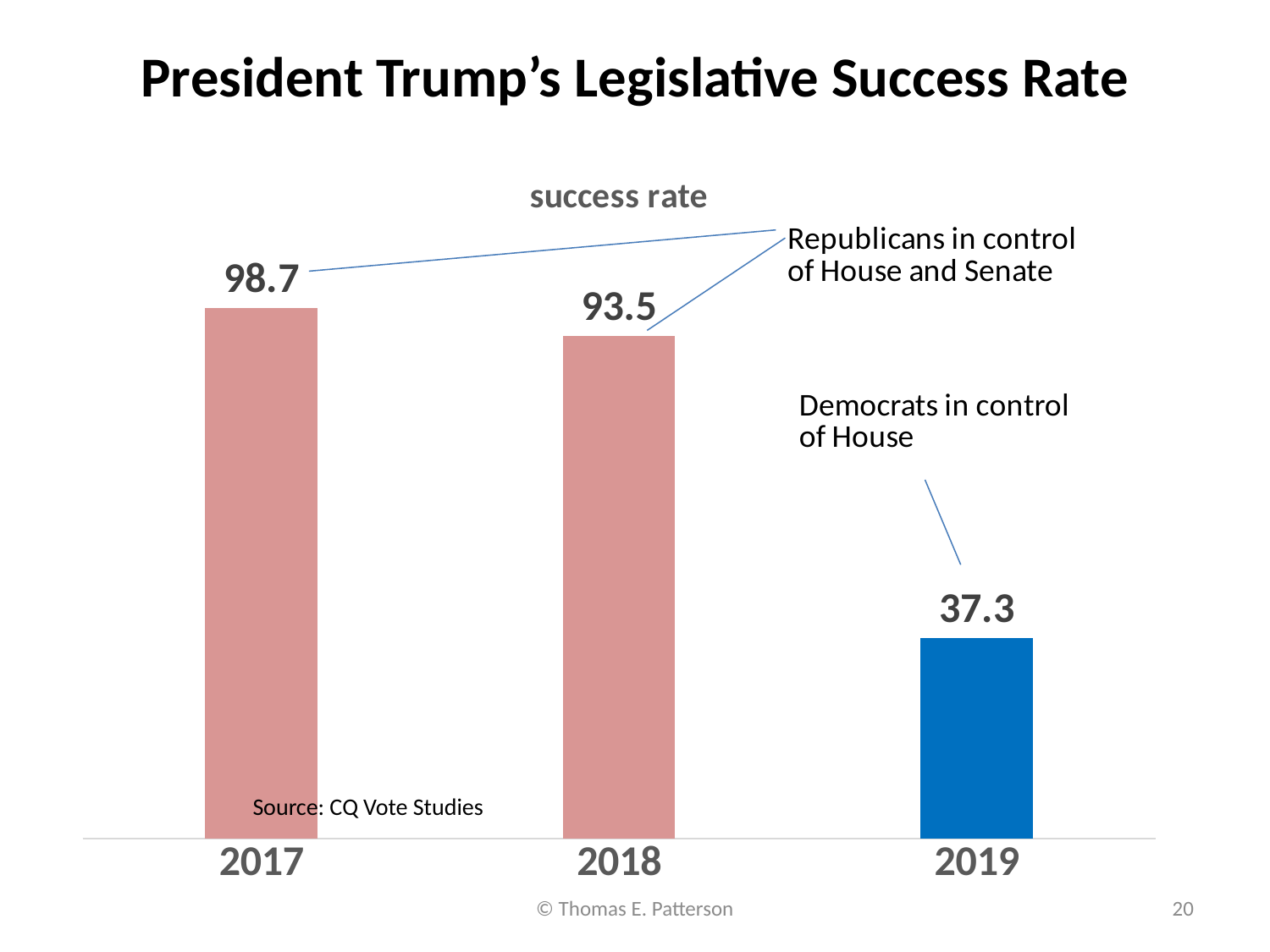
How many years are shown on the chart? 3 What is the success rate for 2018? 93.5 Which year has the lowest success rate? 2019 What kind of chart is shown on the slide? Bar chart Which year has a larger success rate, 2018 or 2019? 2018 What is the success rate for 2019? 37.3 What is the success rate for 2017? 98.7 What is the difference between the success rates for 2018 and 2019? 56.2 What is the difference between the success rates for 2017 and 2018? 5.2 Which year has the highest success rate? 2017 What is the title of the chart? success rate Do the success rates rise or fall from 2017 to 2019? Fall